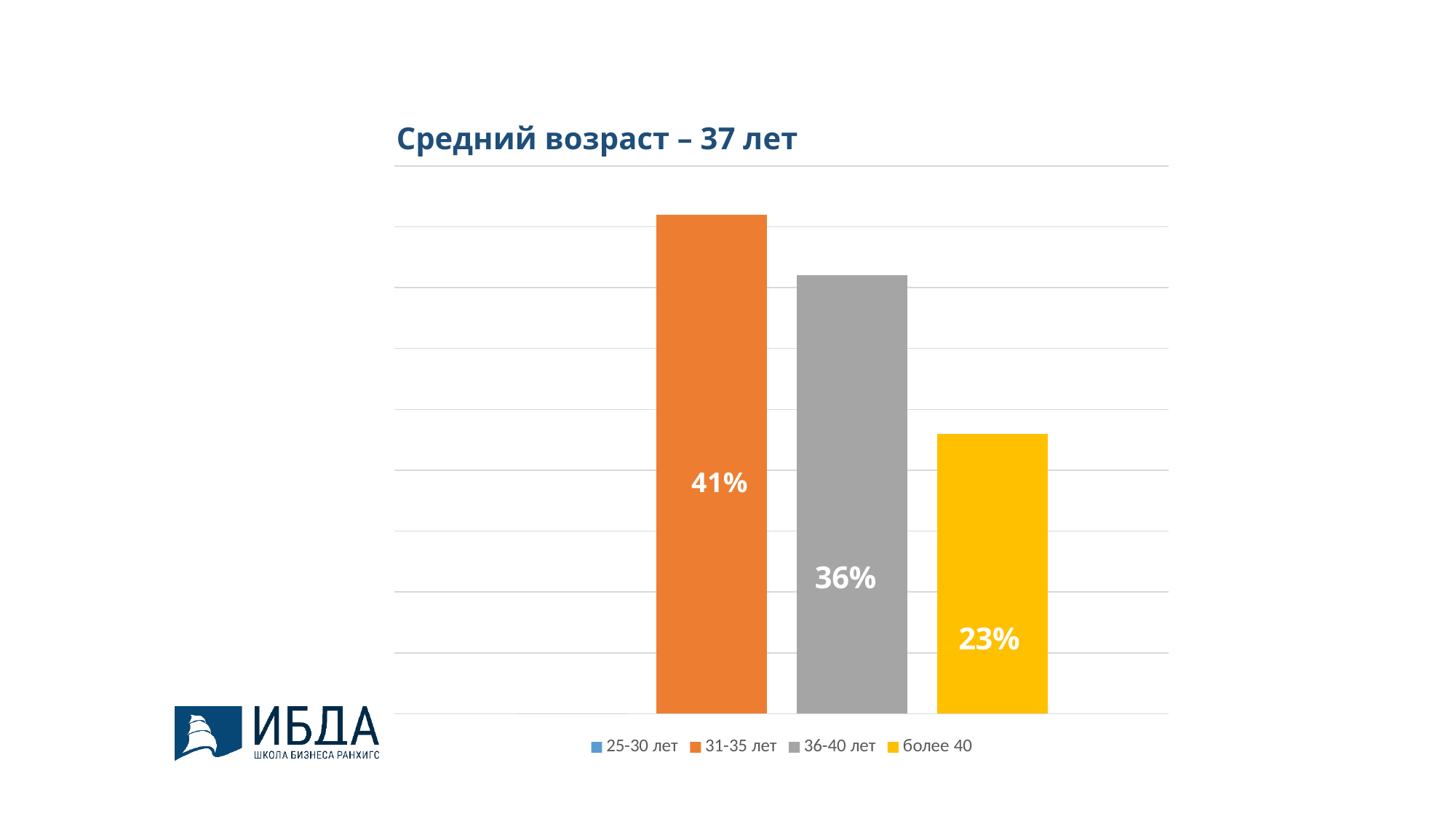
What is the value for the 36-40 лет series? 36% How many bars are plotted on the chart? 3 What kind of chart is shown on the slide? Bar chart Which of the plotted series has the lowest value? более 40 What is the value for the 31-35 лет series? 41% Which is larger, the value for 36-40 лет or the value for более 40? 36-40 лет What is the difference between the values for 36-40 лет and более 40? 13% What is the value for the более 40 series? 23% Which series has the highest value? 31-35 лет How many series does the legend list? 4 What is the difference between the values for 31-35 лет and 36-40 лет? 5% What is the title of the chart? Средний возраст – 37 лет